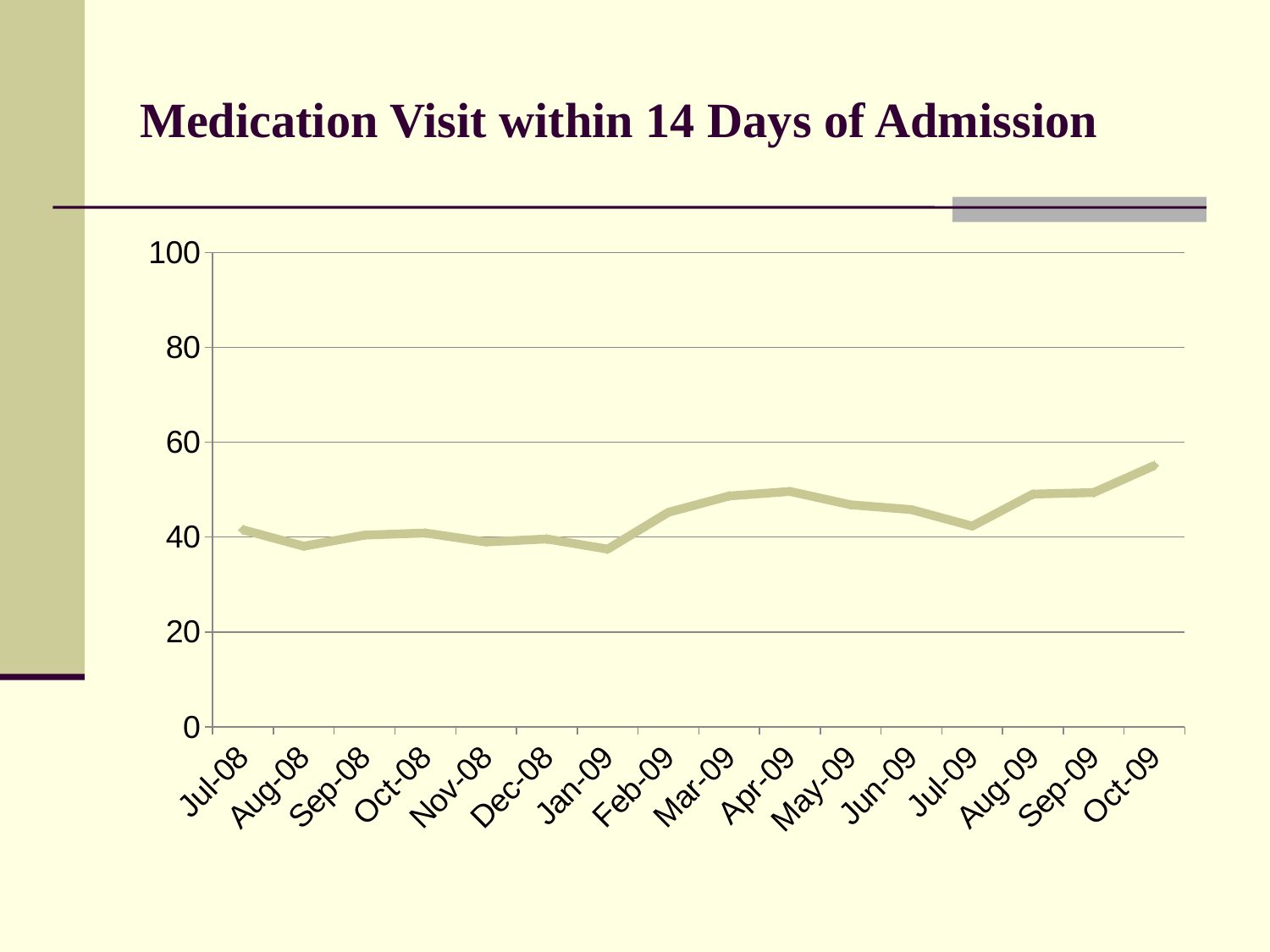
Is the value for Jan-09 greater or less than 40? less What is the title of the chart? Medication Visit within 14 Days of Admission Which is larger, the value for Oct-09 or the value for Jul-08? Oct-09 Which month has the highest value? Oct-09 Is the value for Aug-08 greater or less than 60? less Is the value for Apr-09 greater or less than 40? greater How many months are plotted along the x axis? 16 Which is larger, the value for Mar-09 or the value for Jan-09? Mar-09 What kind of chart is shown on the slide? line chart Overall, do the values rise or fall from Jul-08 to Oct-09? rise